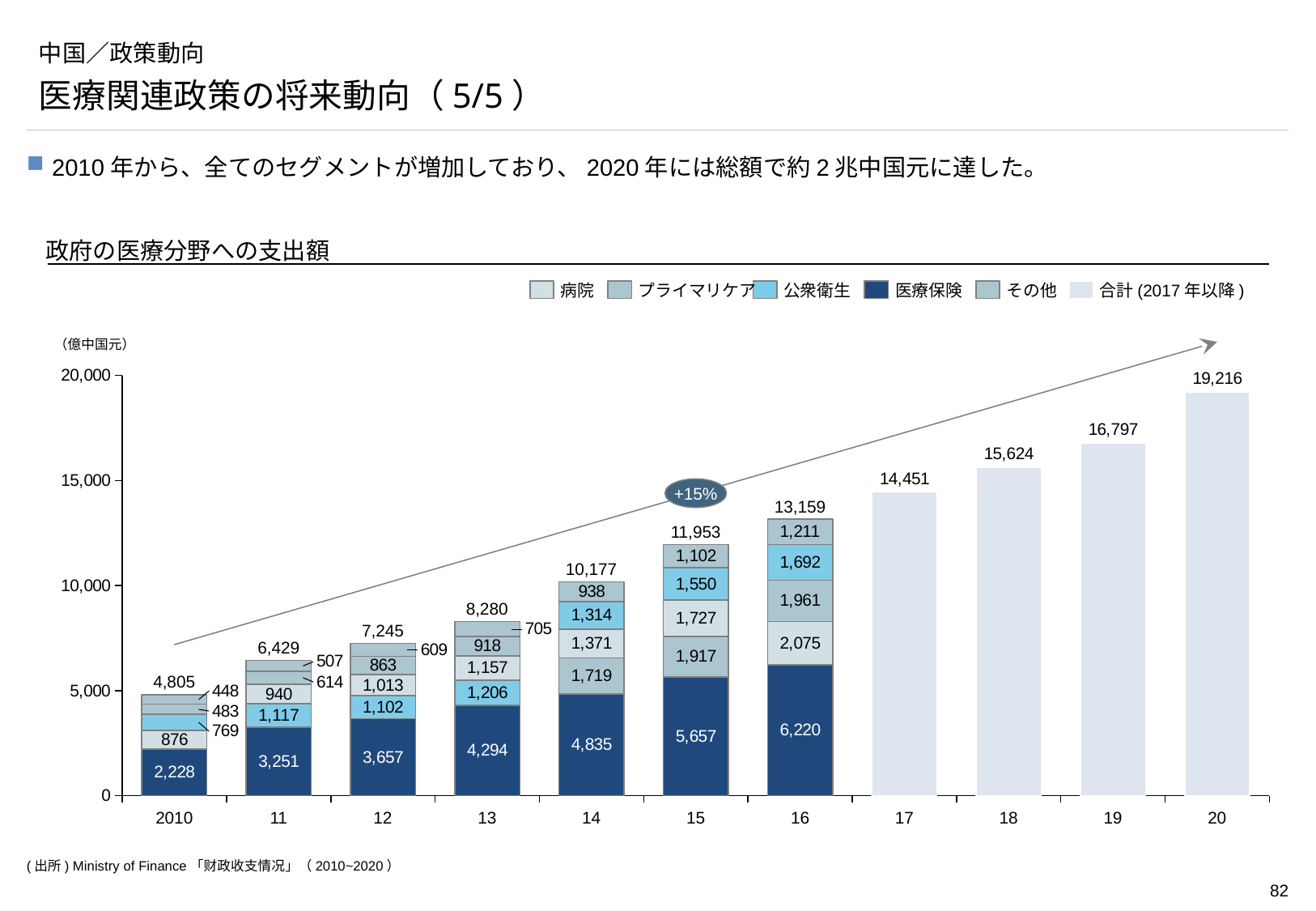
What is the total government health spending shown for 2020 (20)? 19,216 How many entries does the legend list? 6 What is the 医療保険 (medical insurance) value for 2010? 2,228 Which year has the lowest total spending? 2010 What is the difference between the 医療保険 value in 2016 and in 2015? 563 Which year has the highest total spending? 20 (2020) What is the difference between the total for 2020 and the total for 2019? 2,419 What is the 医療保険 (medical insurance) value for 2016? 6,220 How many years are shown on the x axis? 11 What kind of chart is shown on the slide? stacked bar chart What is the total value shown for 2010? 4,805 Which year has a larger total, 2014 or 2015? 2015